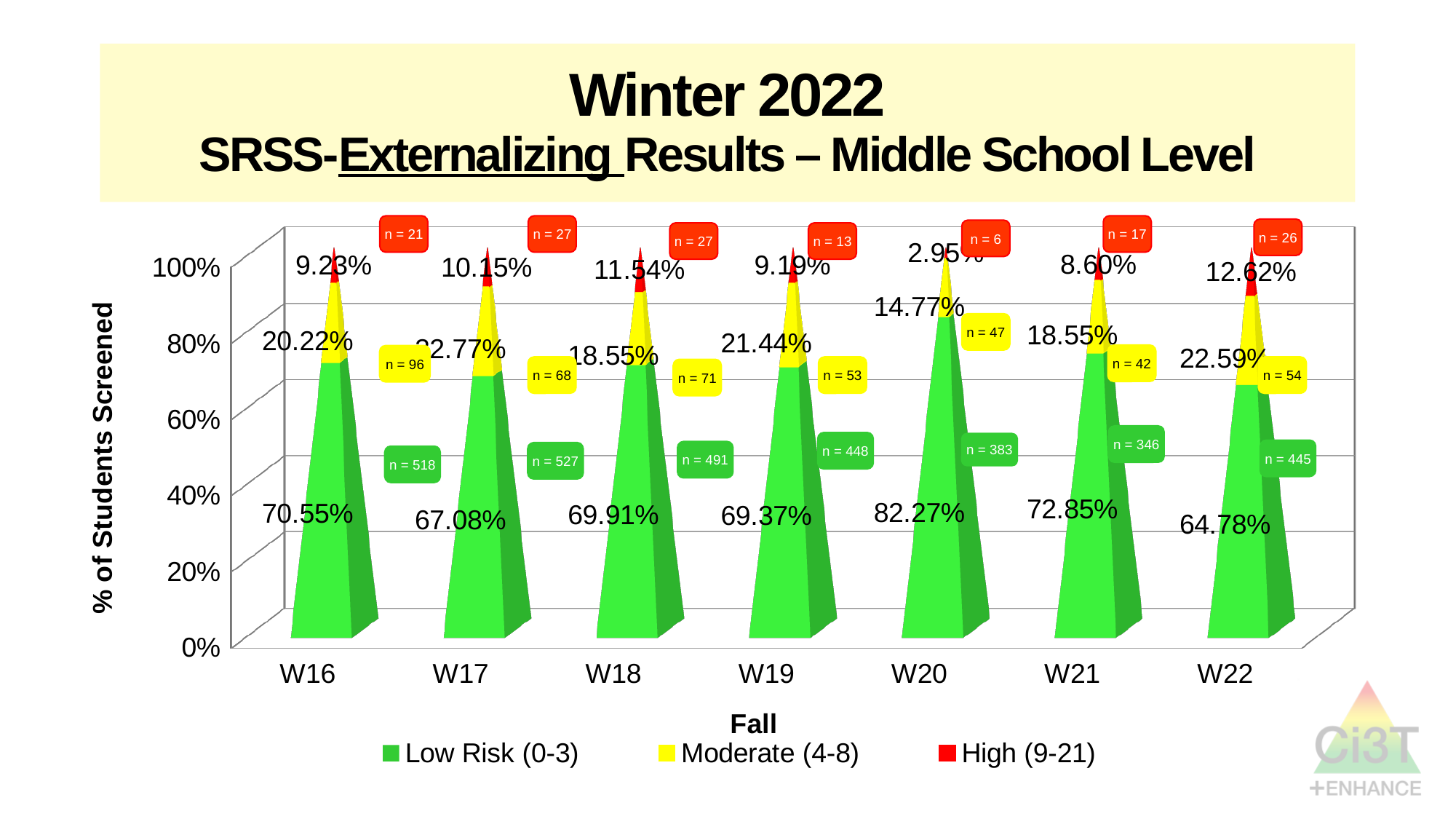
How many series does the legend list? 3 What is the High (9-21) percentage for W22? 12.62% What is the Moderate (4-8) percentage for W19? 21.44% Is the High (9-21) percentage larger for W18 or for W21? W18 Which category has the highest Low Risk (0-3) percentage? W20 What is the Low Risk (0-3) percentage for W20? 82.27% What is the label of the y axis? % of Students Screened Which category has the lowest Low Risk (0-3) percentage? W22 What is the difference between the Low Risk (0-3) percentages for W20 and W22? 17.49% How many categories are shown on the x axis? 7 Which category has the lowest High (9-21) percentage? W20 What is the n value shown for the Low Risk (0-3) group in W17? n = 527